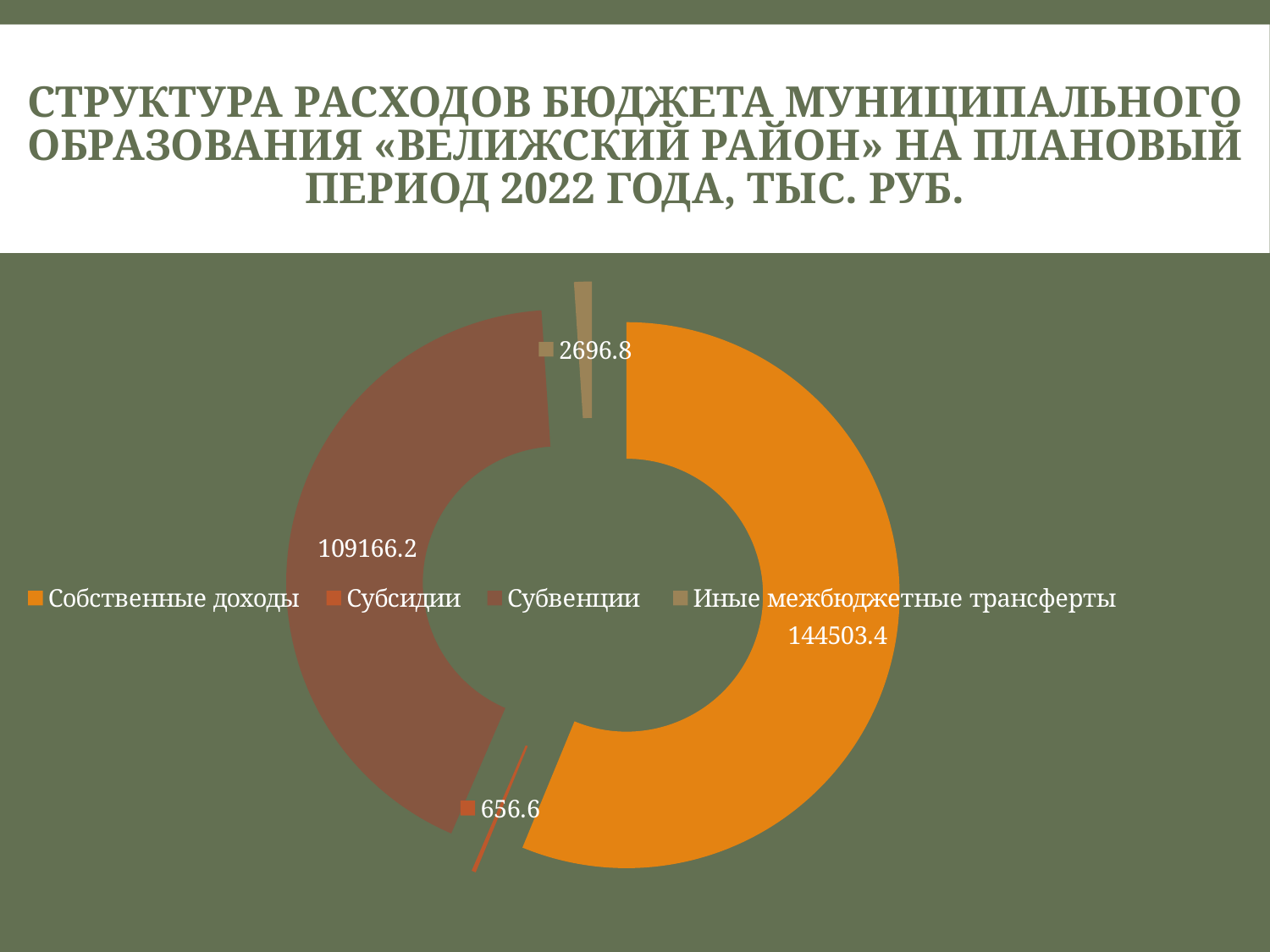
Which category has the lowest value? Субсидии What is the value for Собственные доходы? 144503.4 What is the value for Субвенции? 109166.2 Which category has the highest value? Собственные доходы What is the value for Иные межбюджетные трансферты? 2696.8 What is the difference between Собственные доходы and Субвенции? 35337.2 What kind of chart is shown on the slide? Doughnut chart How many categories does the chart show? 4 What is the value for Субсидии? 656.6 What is the difference between Иные межбюджетные трансферты and Субсидии? 2040.2 Which is larger, Субвенции or Иные межбюджетные трансферты? Субвенции What is the total of all four categories shown in the chart? 257023.0